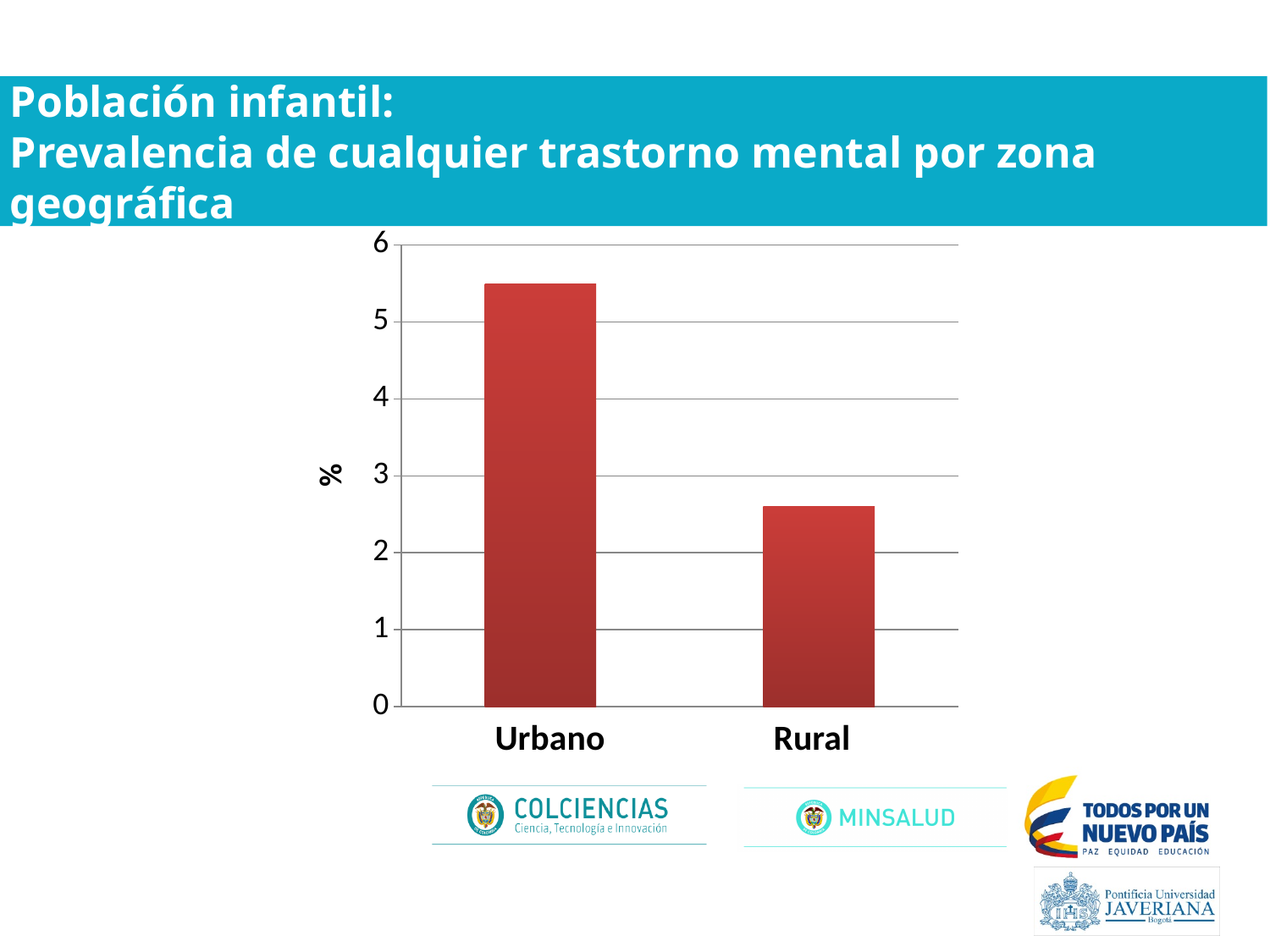
Is the value for Urbano greater or less than 6? less Is the value for Rural greater or less than 3? less How many categories are plotted on the chart? 2 Which zone has the lowest prevalence value? Rural Is the value for Urbano greater or less than 5? greater Which zone has the highest prevalence value? Urbano What is the label on the vertical axis of the chart? % Which is larger, the value for Urbano or the value for Rural? Urbano What is the highest value shown on the vertical axis? 6 What kind of chart is shown on the slide? bar chart